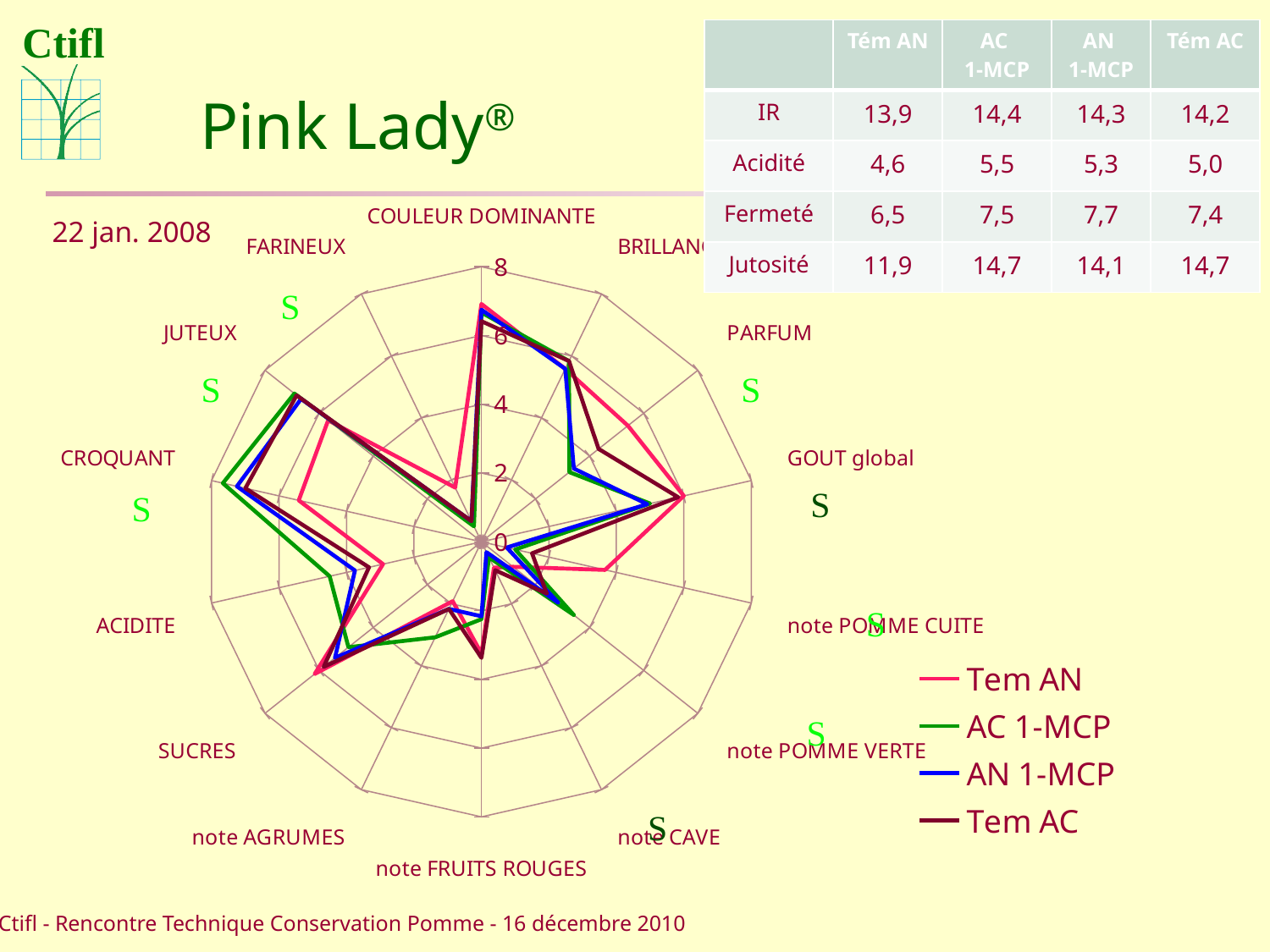
Is the value for GOUT global for the Tem AN series greater or less than 4? greater Which series is drawn in green on the radar chart? AC 1-MCP For JUTEUX, which series has the larger value: AC 1-MCP or Tem AN? AC 1-MCP Is the value for CROQUANT for the AC 1-MCP series greater or less than 6? greater How many attribute axes (categories) does the radar chart have? 14 Is the value for SUCRES for the Tem AN series greater or less than 4? greater How many series does the chart legend list? 4 For CROQUANT, which series has the larger value: AC 1-MCP or Tem AN? AC 1-MCP What kind of chart is shown on the slide? Radar chart What is the highest value marked on the radar chart's scale? 8